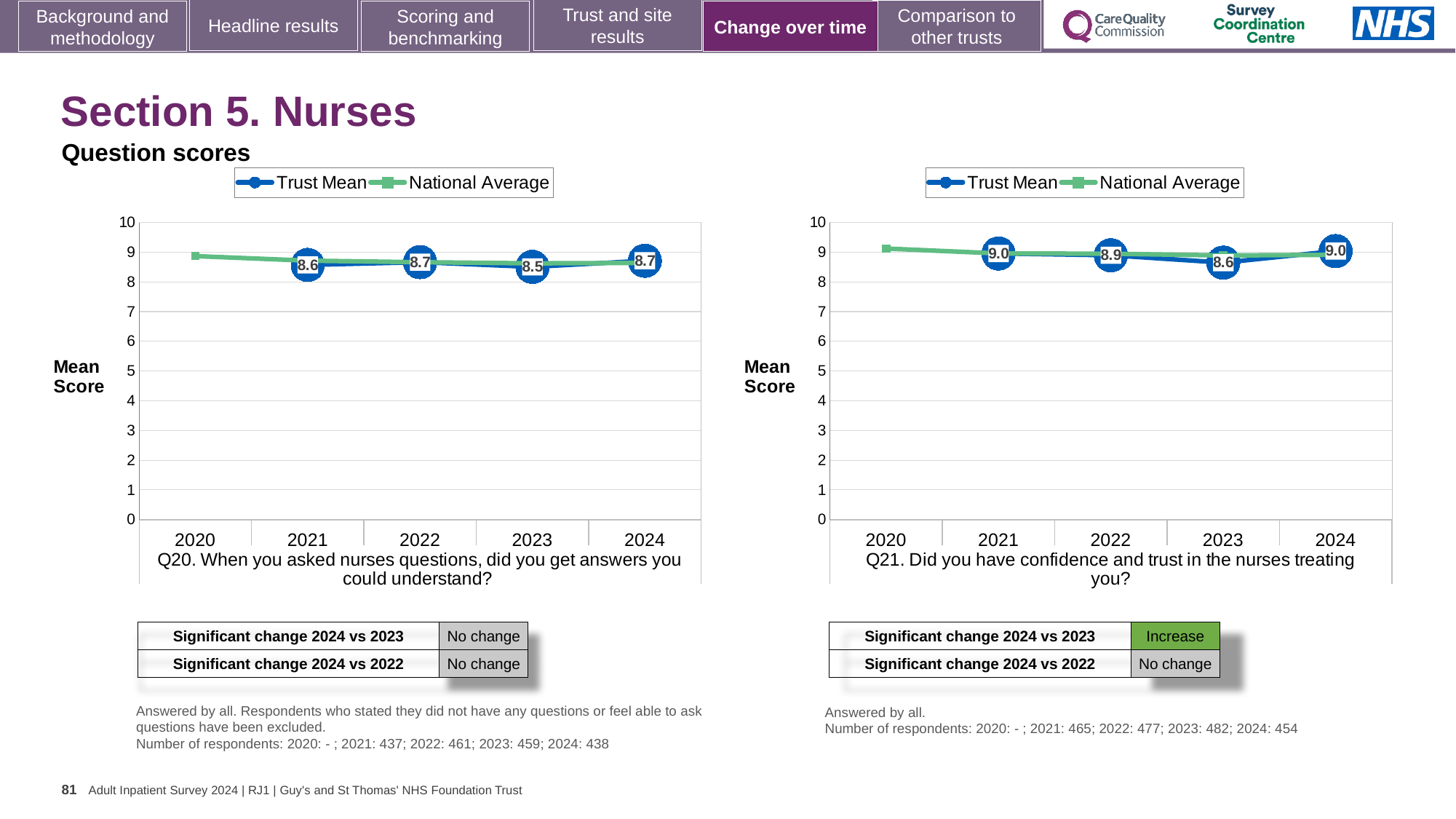
In the Q21 chart on the right, what is the Trust Mean score for 2022? 8.9 In the Q20 chart on the left, which year has the lowest Trust Mean score? 2023 What type of chart is used for the Q20 chart on the left? Line chart In the Q20 chart on the left, what is the Trust Mean score for 2023? 8.5 In the Q21 chart on the right, what is the difference between the Trust Mean scores for 2024 and 2023? 0.4 How many years are shown on the x axis of the Q20 chart on the left? 5 In the Q21 chart on the right, what is the Trust Mean score for 2023? 8.6 In the Q20 chart on the left, is the Trust Mean score higher in 2022 or in 2023? 2022 How many series does the legend of the Q21 chart on the right list? 2 In the Q20 chart on the left, what is the Trust Mean score for 2024? 8.7 In the Q21 chart on the right, which year has the lowest Trust Mean score? 2023 In the Q21 chart on the right, is the National Average value for 2020 greater or less than 8? greater